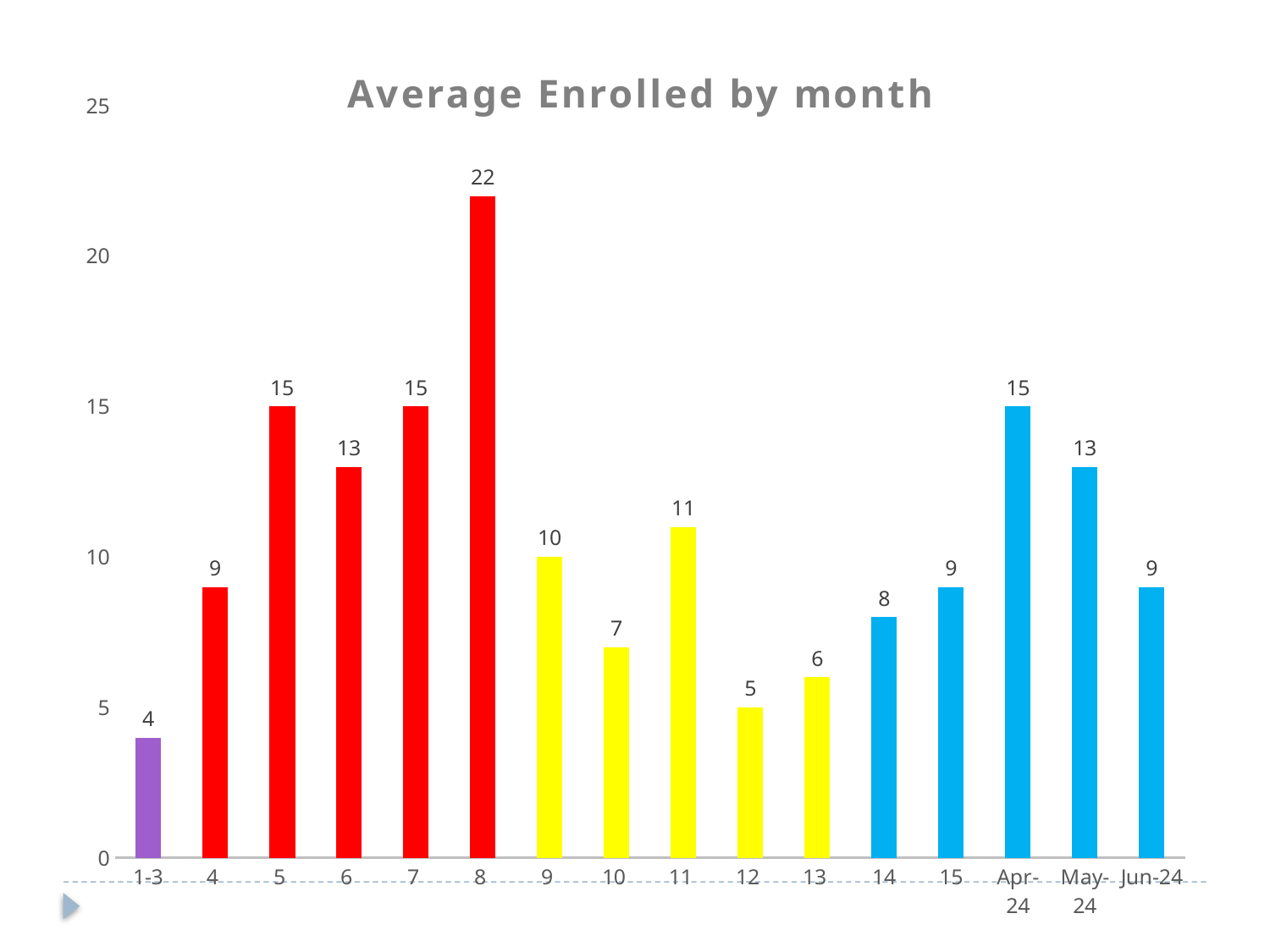
Which is larger, the value for category 11 or the value for category 14? 11 What is the title of the chart? Average Enrolled by month What is the value for category 1-3? 4 What colour is the bar for category 1-3? purple How many categories are shown on the x axis? 16 What is the difference between the values for category 8 and category 12? 17 What kind of chart is this? bar chart What is the value for Apr-24? 15 Which category has the lowest value? 1-3 What is the value for category 8? 22 Which category has the highest value? 8